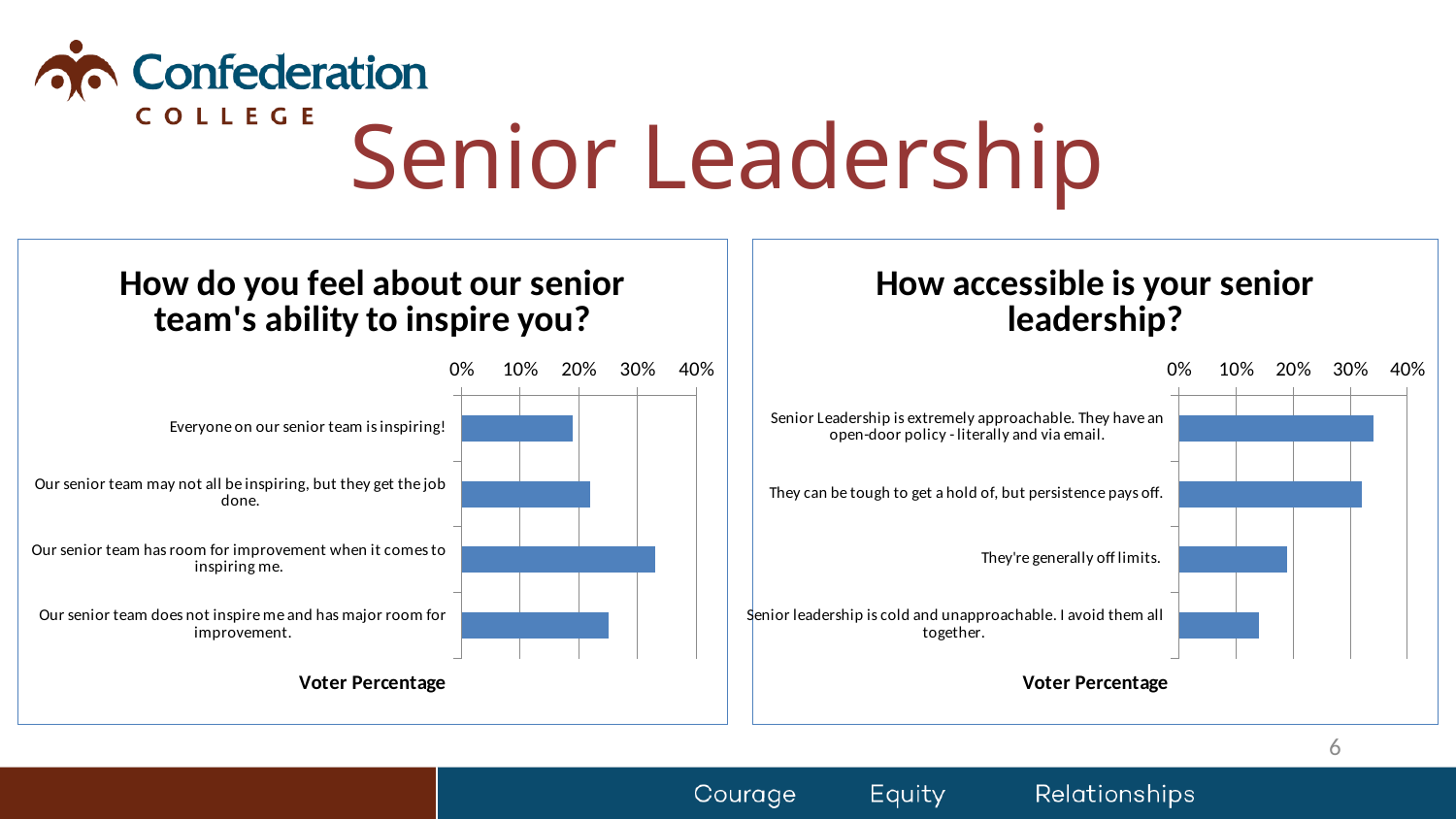
In the chart titled "How do you feel about our senior team's ability to inspire you?", what kind of chart is used? bar chart In the chart titled "How do you feel about our senior team's ability to inspire you?", which response has the highest voter percentage? Our senior team has room for improvement when it comes to inspiring me. In the chart titled "How accessible is your senior leadership?", which is larger: the value for "They're generally off limits." or the value for "Senior leadership is cold and unapproachable. I avoid them all together."? They're generally off limits. In the chart titled "How do you feel about our senior team's ability to inspire you?", is the value for "Our senior team has room for improvement when it comes to inspiring me." greater or less than 30%? greater In the chart titled "How accessible is your senior leadership?", which response has the lowest voter percentage? Senior leadership is cold and unapproachable. I avoid them all together. In the chart titled "How do you feel about our senior team's ability to inspire you?", how many response categories are shown? 4 In the chart titled "How accessible is your senior leadership?", what is the label on the value axis? Voter Percentage In the chart titled "How accessible is your senior leadership?", how many response categories are shown? 4 In the chart titled "How do you feel about our senior team's ability to inspire you?", which response has the lowest voter percentage? Everyone on our senior team is inspiring! In the chart titled "How accessible is your senior leadership?", is the value for "Senior Leadership is extremely approachable. They have an open-door policy - literally and via email." greater or less than 30%? greater